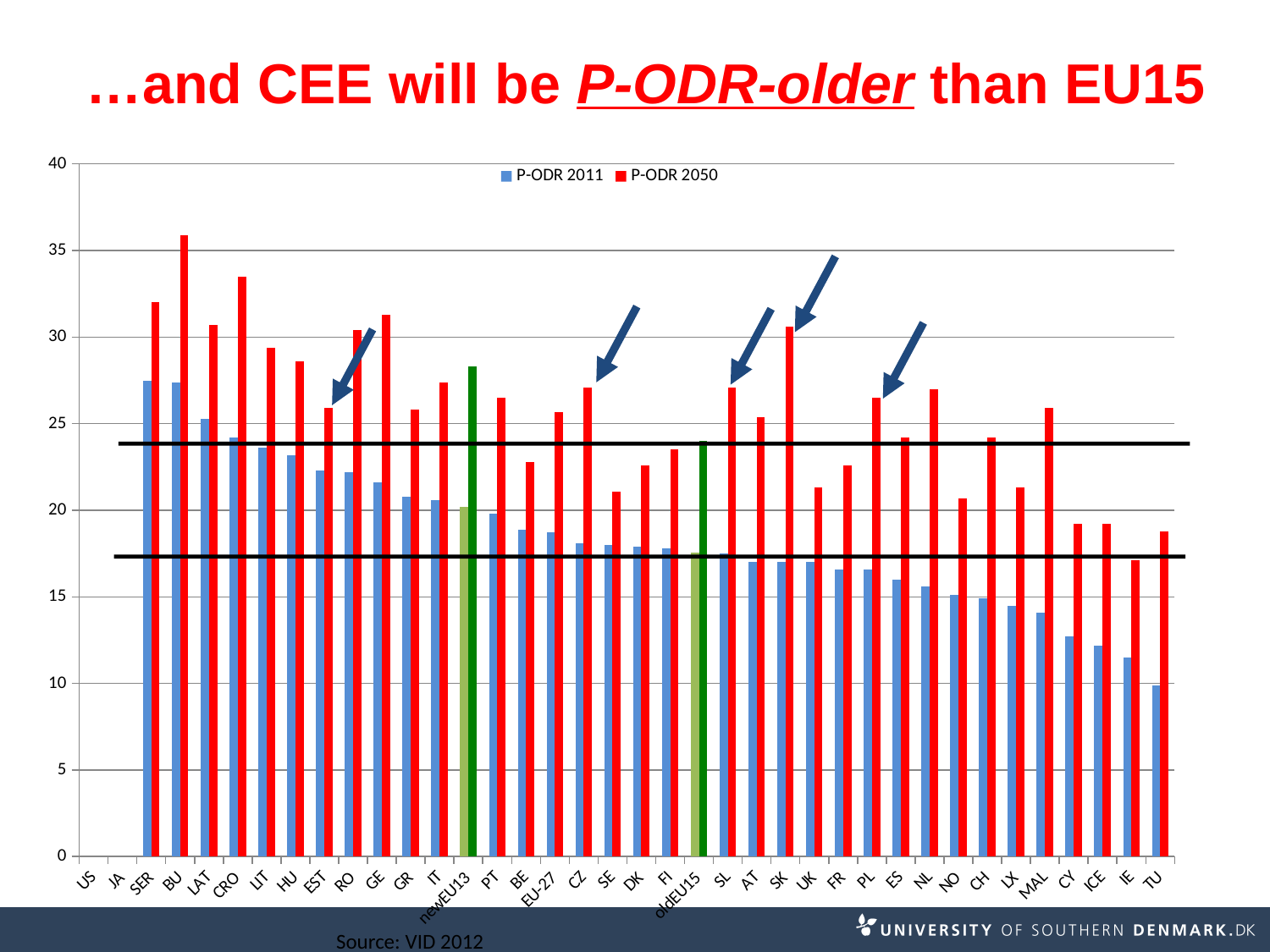
Which category has the highest P-ODR 2050 value? BU How many series does the legend list? 2 Which is larger, the P-ODR 2011 value for SER or for TU? SER Is the P-ODR 2050 value for IE greater or less than 20? less What kind of chart is shown on the slide? bar chart What are the two series named in the legend? P-ODR 2011 and P-ODR 2050 Is the P-ODR 2011 value for TU greater or less than 15? less Which colour represents the P-ODR 2050 series? red Which is larger, the P-ODR 2050 value for BU or for CRO? BU Is the P-ODR 2011 value for SER greater or less than 25? greater Do the P-ODR 2011 values generally rise or fall moving from left to right along the x axis? fall